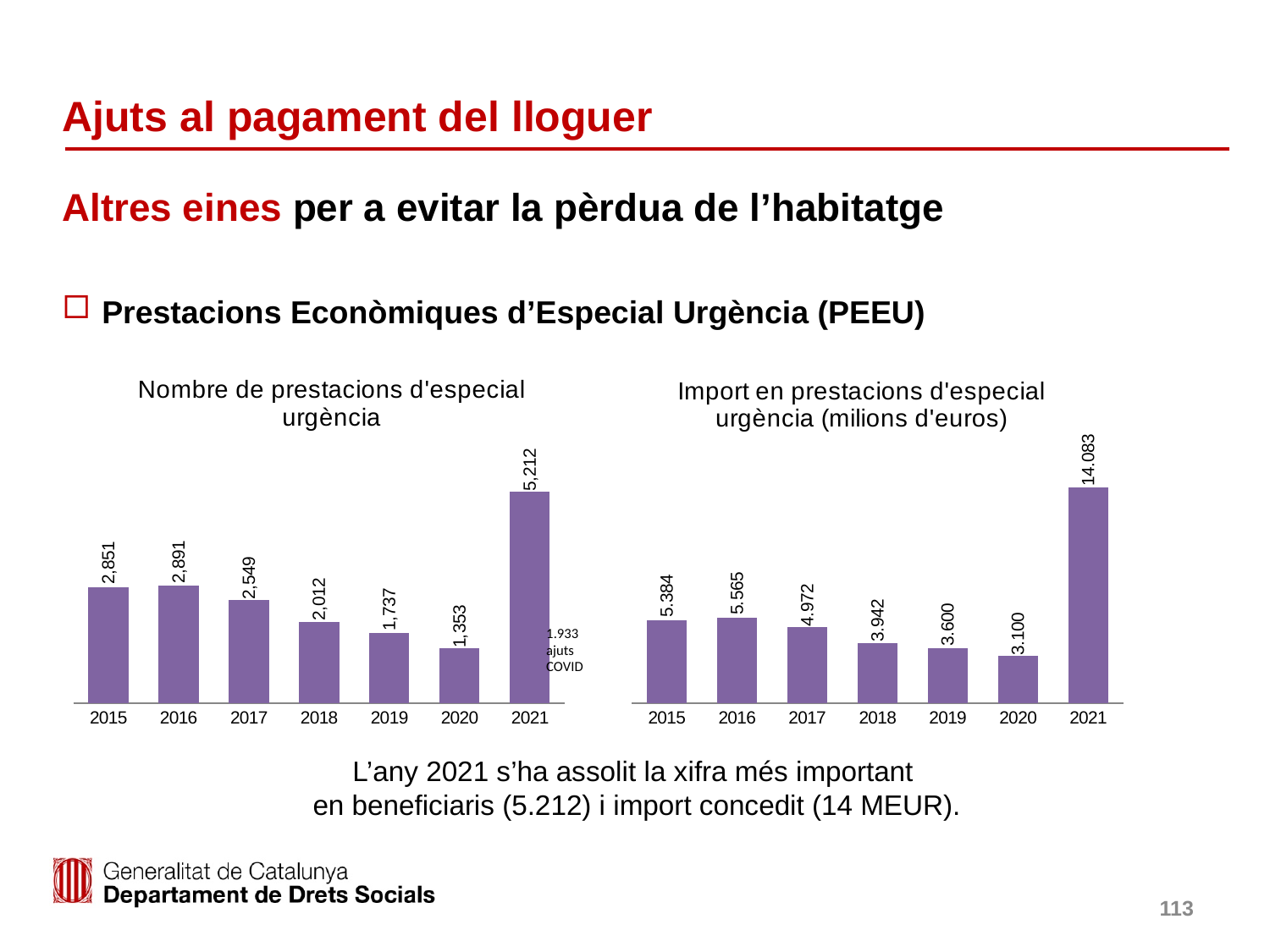
In the chart 'Import en prestacions d'especial urgència (milions d'euros)', what is the value for 2021? 14.083 In the chart 'Nombre de prestacions d'especial urgència', what is the value for 2021? 5,212 In the chart 'Nombre de prestacions d'especial urgència', how many years are shown on the x axis? 7 In the chart 'Import en prestacions d'especial urgència (milions d'euros)', do the values rise or fall from 2016 to 2020? fall In the chart 'Nombre de prestacions d'especial urgència', which year has the lowest value? 2020 In the chart 'Import en prestacions d'especial urgència (milions d'euros)', what is the difference between the 2016 value and the 2015 value? 0.181 In the chart 'Nombre de prestacions d'especial urgència', which is larger, the value for 2015 or the value for 2016? 2016 What kind of chart is the left chart, 'Nombre de prestacions d'especial urgència'? bar chart In the chart 'Nombre de prestacions d'especial urgència', what is the value for 2019? 1,737 In the chart 'Import en prestacions d'especial urgència (milions d'euros)', what is the value for 2018? 3.942 In the chart 'Import en prestacions d'especial urgència (milions d'euros)', which year has the highest value? 2021 In the chart 'Nombre de prestacions d'especial urgència', what is the difference between the 2021 value and the 2020 value? 3,859